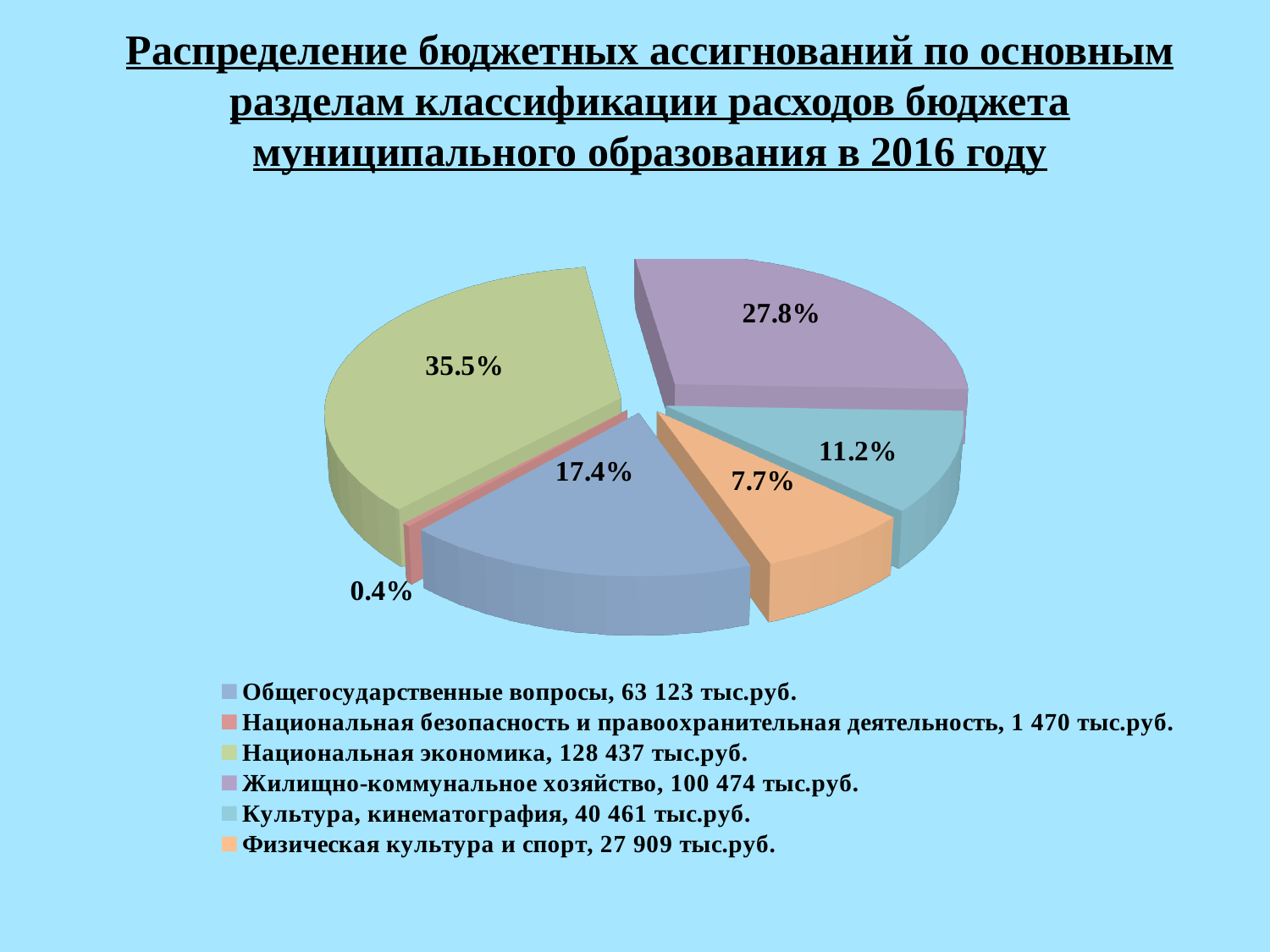
What is the difference in percentage points between the Национальная экономика slice and the Жилищно-коммунальное хозяйство slice? 7.7 How many slices does the pie chart have? 6 According to the legend, what is the amount for Национальная безопасность и правоохранительная деятельность? 1 470 тыс.руб. What share of the pie does Национальная экономика have? 35.5% What kind of chart is shown on the slide? pie chart What share of the pie does Физическая культура и спорт have? 7.7% According to the legend, what is the amount for Культура, кинематография? 40 461 тыс.руб. Which is larger: the share for Жилищно-коммунальное хозяйство or the share for Культура, кинематография? Жилищно-коммунальное хозяйство What share of the pie does Жилищно-коммунальное хозяйство have? 27.8% Which category has the smallest slice of the pie? Национальная безопасность и правоохранительная деятельность Which category has the largest slice of the pie? Национальная экономика